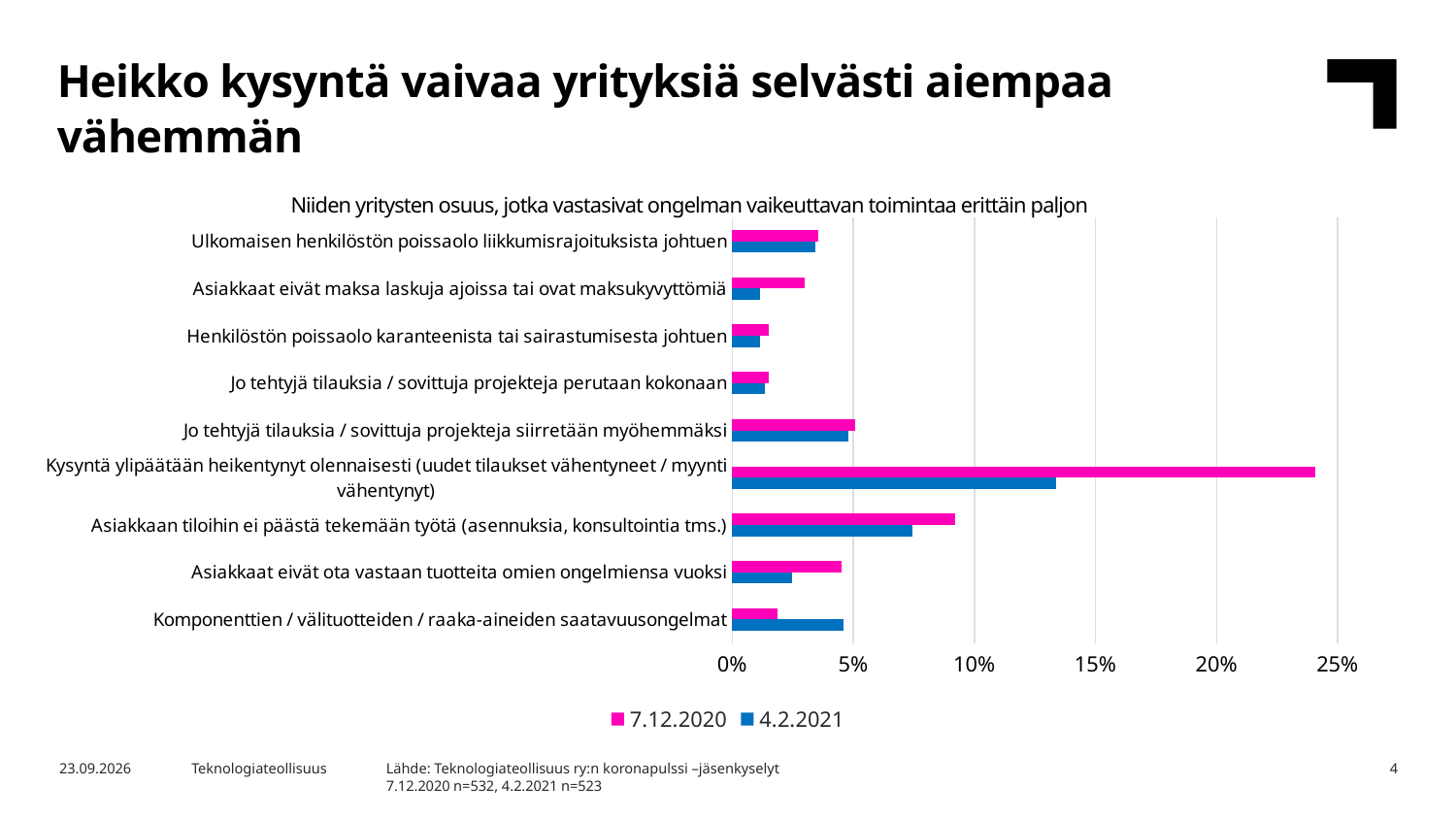
Is the 7.12.2020 value for 'Asiakkaan tiloihin ei päästä tekemään työtä' greater or less than 10%? less For 'Asiakkaat eivät maksa laskuja ajoissa tai ovat maksukyvyttömiä', which series has the larger value, 7.12.2020 or 4.2.2021? 7.12.2020 Is the 7.12.2020 value for 'Kysyntä ylipäätään heikentynyt olennaisesti' greater or less than 20%? greater Which category has the highest value for the 7.12.2020 series? Kysyntä ylipäätään heikentynyt olennaisesti (uudet tilaukset vähentyneet / myynti vähentynyt) How many series does the legend list? 2 Is the 4.2.2021 value for 'Kysyntä ylipäätään heikentynyt olennaisesti' greater or less than 15%? less What is the title of the chart? Niiden yritysten osuus, jotka vastasivat ongelman vaikeuttavan toimintaa erittäin paljon For 'Komponenttien / välituotteiden / raaka-aineiden saatavuusongelmat', which series has the larger value, 7.12.2020 or 4.2.2021? 4.2.2021 What kind of chart is shown on the slide? Bar chart Which category has the highest value for the 4.2.2021 series? Kysyntä ylipäätään heikentynyt olennaisesti (uudet tilaukset vähentyneet / myynti vähentynyt) How many categories are plotted on the chart? 9 Which colour represents the 4.2.2021 series in the legend? Blue